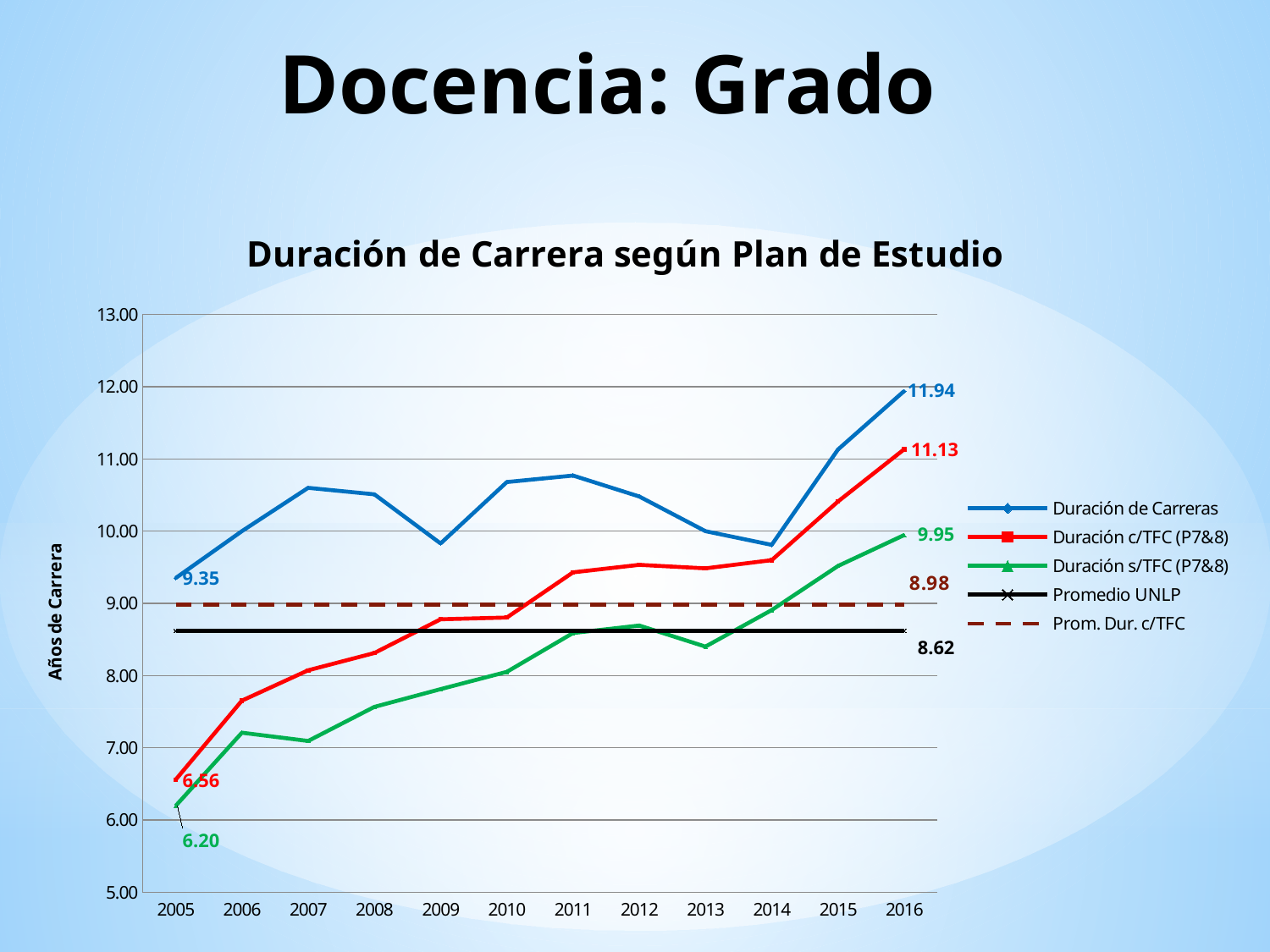
What is the title of the y axis? Años de Carrera What type of chart is shown on the slide? line chart What is the value of Duración de Carreras in 2016? 11.94 By how much did Duración de Carreras increase from 2005 to 2016? 2.59 What is the value of Duración c/TFC (P7&8) in 2005? 6.56 What is the difference between the 2016 and 2005 values of Duración c/TFC (P7&8)? 4.57 What is the value of Duración s/TFC (P7&8) in 2016? 9.95 Is the value of Duración de Carreras in 2011 greater or less than 10.00? greater What value is labelled for Promedio UNLP? 8.62 How many years are shown on the x axis? 12 What value is labelled for Prom. Dur. c/TFC? 8.98 How many series does the legend list? 5